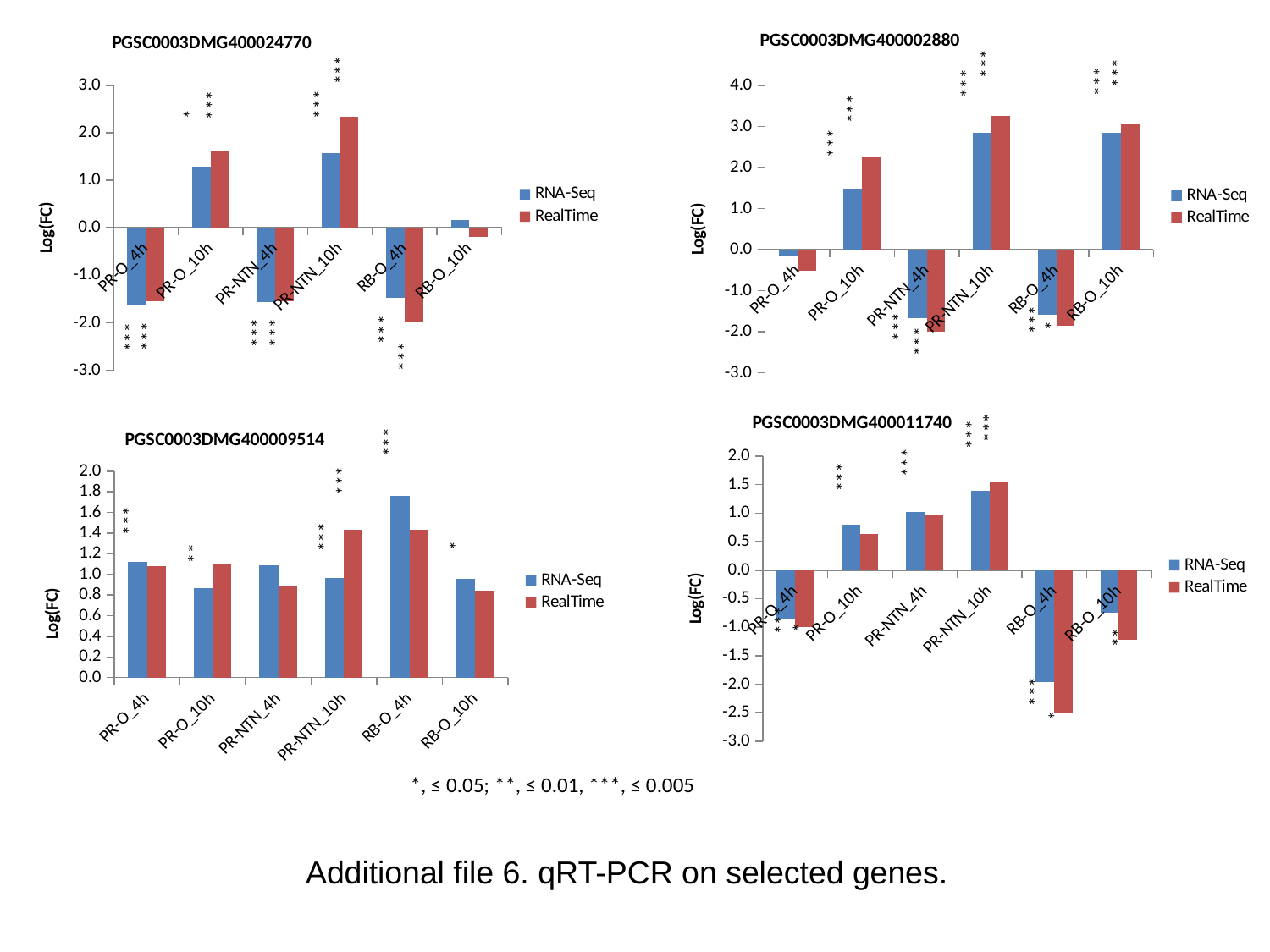
How many categories are shown on the x axis of the PGSC0003DMG400009514 chart (bottom-left)? 6 In the PGSC0003DMG400009514 chart (bottom-left), is the RNA-Seq value for RB-O_4h greater or less than 1.4? greater In the PGSC0003DMG400009514 chart (bottom-left), which is larger for RB-O_4h, RNA-Seq or RealTime? RNA-Seq In the PGSC0003DMG400002880 chart (top-right), is the RNA-Seq value for PR-NTN_10h greater or less than 2.0? greater In the PGSC0003DMG400009514 chart (bottom-left), which category has the highest RNA-Seq value? RB-O_4h In the PGSC0003DMG400024770 chart (top-left), which category has the highest RealTime value? PR-NTN_10h What is the y-axis label on the PGSC0003DMG400011740 chart (bottom-right)? Log(FC) In the PGSC0003DMG400002880 chart (top-right), which is larger for PR-O_10h, RNA-Seq or RealTime? RealTime What kind of chart is used for PGSC0003DMG400024770 (top-left)? Bar chart In the PGSC0003DMG400024770 chart (top-left), is the RealTime value for RB-O_4h greater or less than -1.0? less How many series does the legend list for the PGSC0003DMG400002880 chart (top-right)? 2 In the PGSC0003DMG400011740 chart (bottom-right), which category has the lowest RealTime value? RB-O_4h